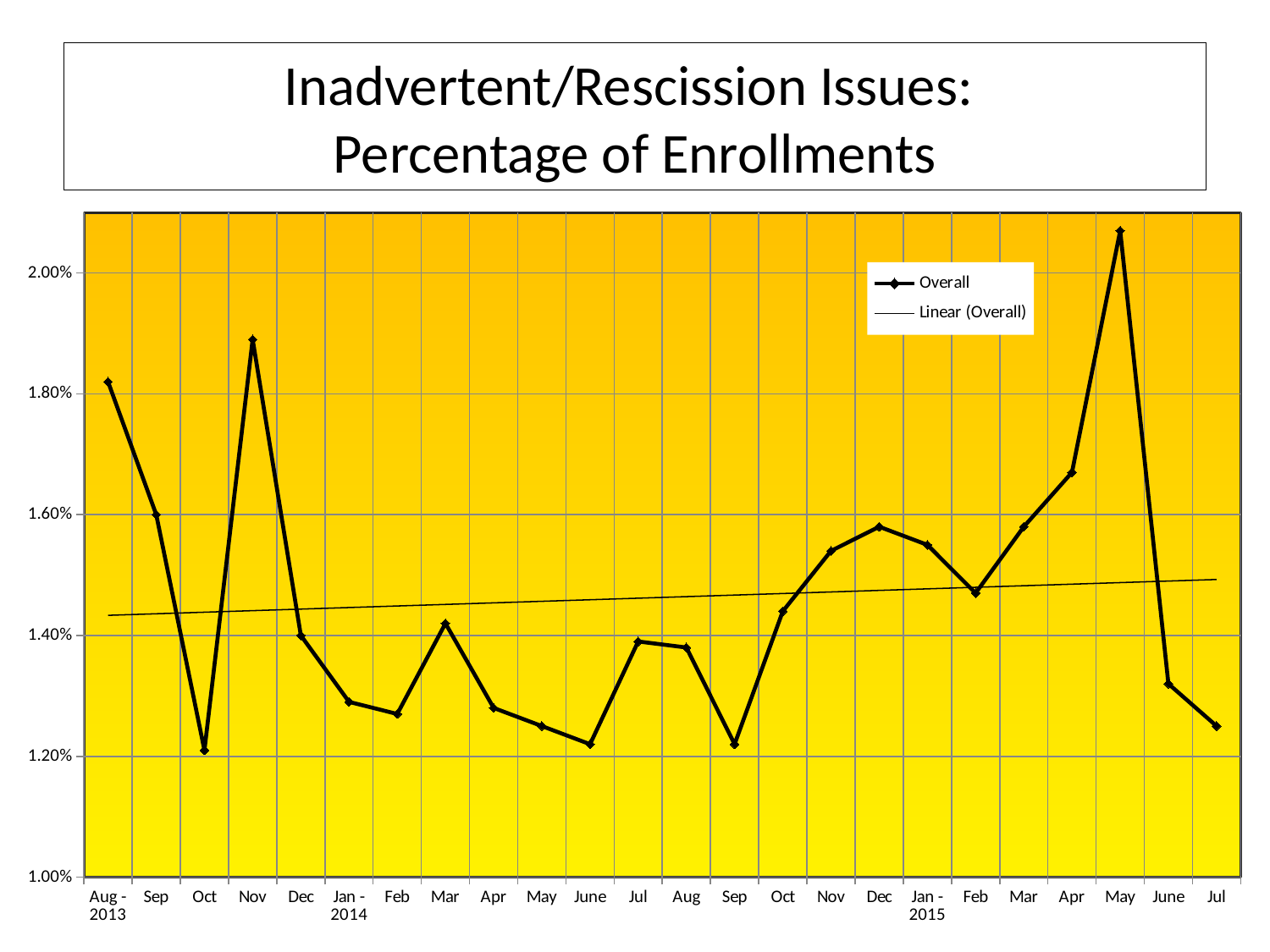
In which month does the Overall line reach its highest value? May 2015 Which month has the larger Overall value, Nov 2013 or Dec 2013? Nov 2013 Is the Overall value for Oct 2013 greater or less than 1.40%? less Is the Overall value for Jul 2015 greater or less than 1.40%? less How many entries does the legend list? 2 What is the title of the chart? Inadvertent/Rescission Issues: Percentage of Enrollments Does the Linear (Overall) trend line rise or fall from left to right? Rises What are the two entries listed in the legend? Overall and Linear (Overall) What kind of chart is shown on the slide? Line chart Is the Overall value for May 2015 greater or less than 2.00%? greater How many monthly data points are plotted on the Overall line? 24